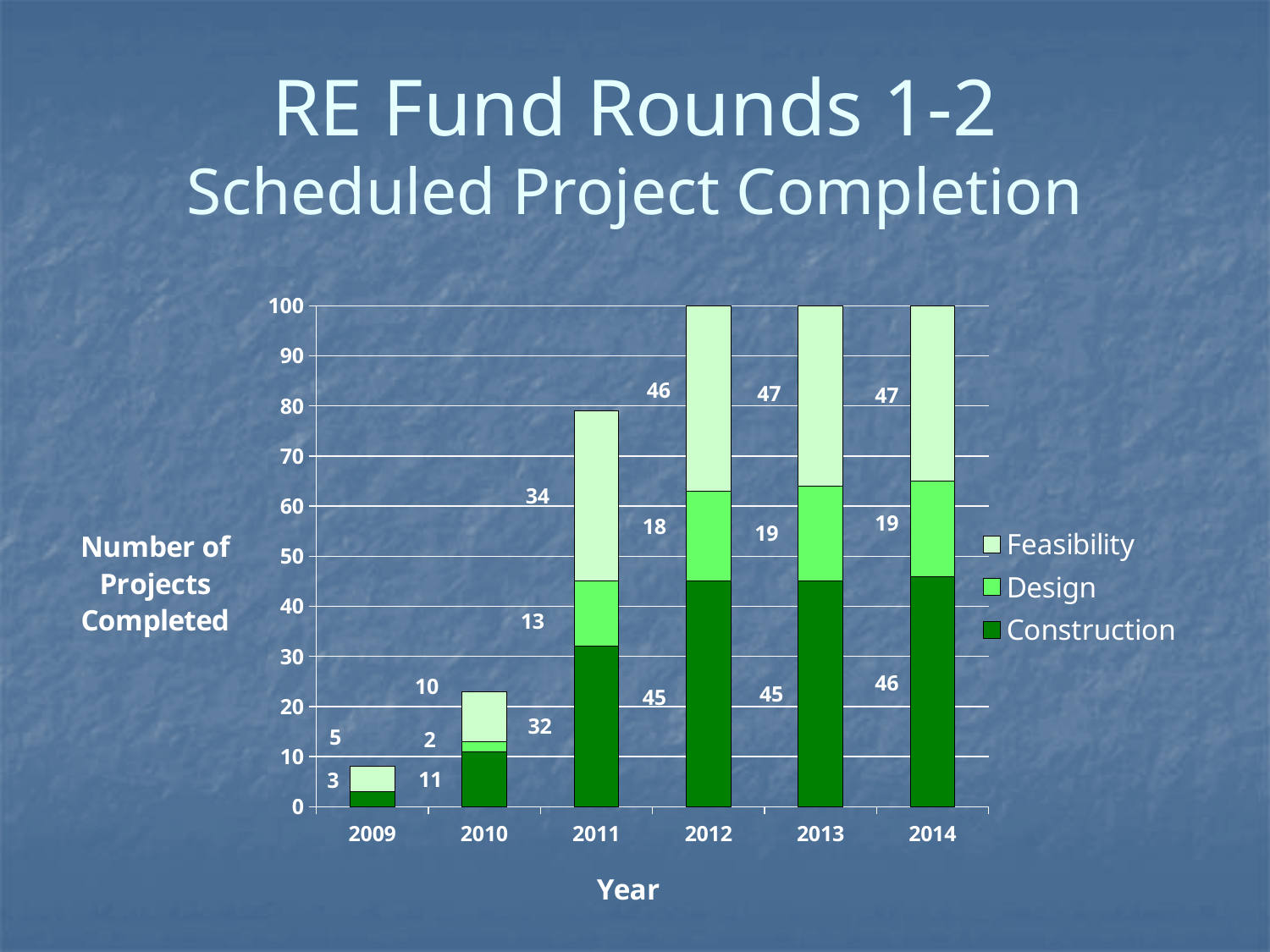
What is the Feasibility value for 2013? 47 What type of chart is shown on the slide? stacked bar chart What is the difference between the Feasibility values for 2011 and 2010? 24 What is the Design value for 2010? 2 What is the Construction value for 2011? 32 Is the Design value for 2012 larger or smaller than the Design value for 2011? larger Does the Construction value rise or fall from 2009 to 2014? rise What is the total of the stacked bar for 2010? 23 Which year has the highest Construction value? 2014 How many years are shown on the x axis? 6 Which year has the lowest Construction value? 2009 How many series does the legend list? 3